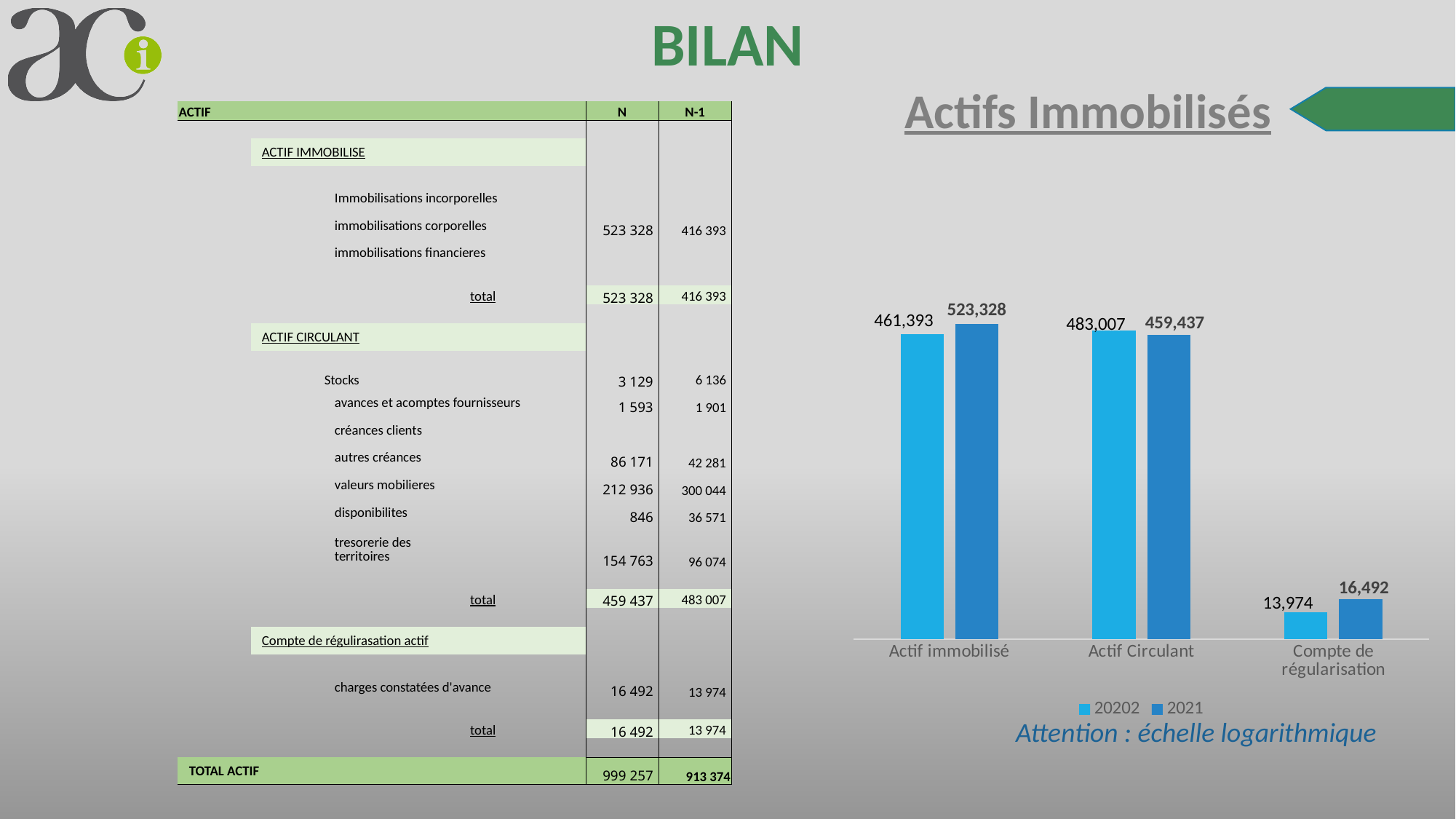
What is the value of the 2021 bar for Actif immobilisé? 523,328 What is the value of the 20202 bar for Actif immobilisé? 461,393 What is the value of the 20202 bar for Actif Circulant? 483,007 According to the note under the chart, what kind of scale does the chart use? logarithmic (échelle logarithmique) What is the difference between the 2021 and 20202 values for Actif immobilisé? 61,935 Which category has the lowest values in the chart? Compte de régularisation What is the value of the 2021 bar for Compte de régularisation? 16,492 How many categories are shown on the x axis of the chart? 3 How many series does the chart legend list? 2 What type of chart is shown on the slide? bar chart For Actif Circulant, which series has the larger value, 20202 or 2021? 20202 Which bar has the highest value in the chart? Actif immobilisé, 2021 (523,328)